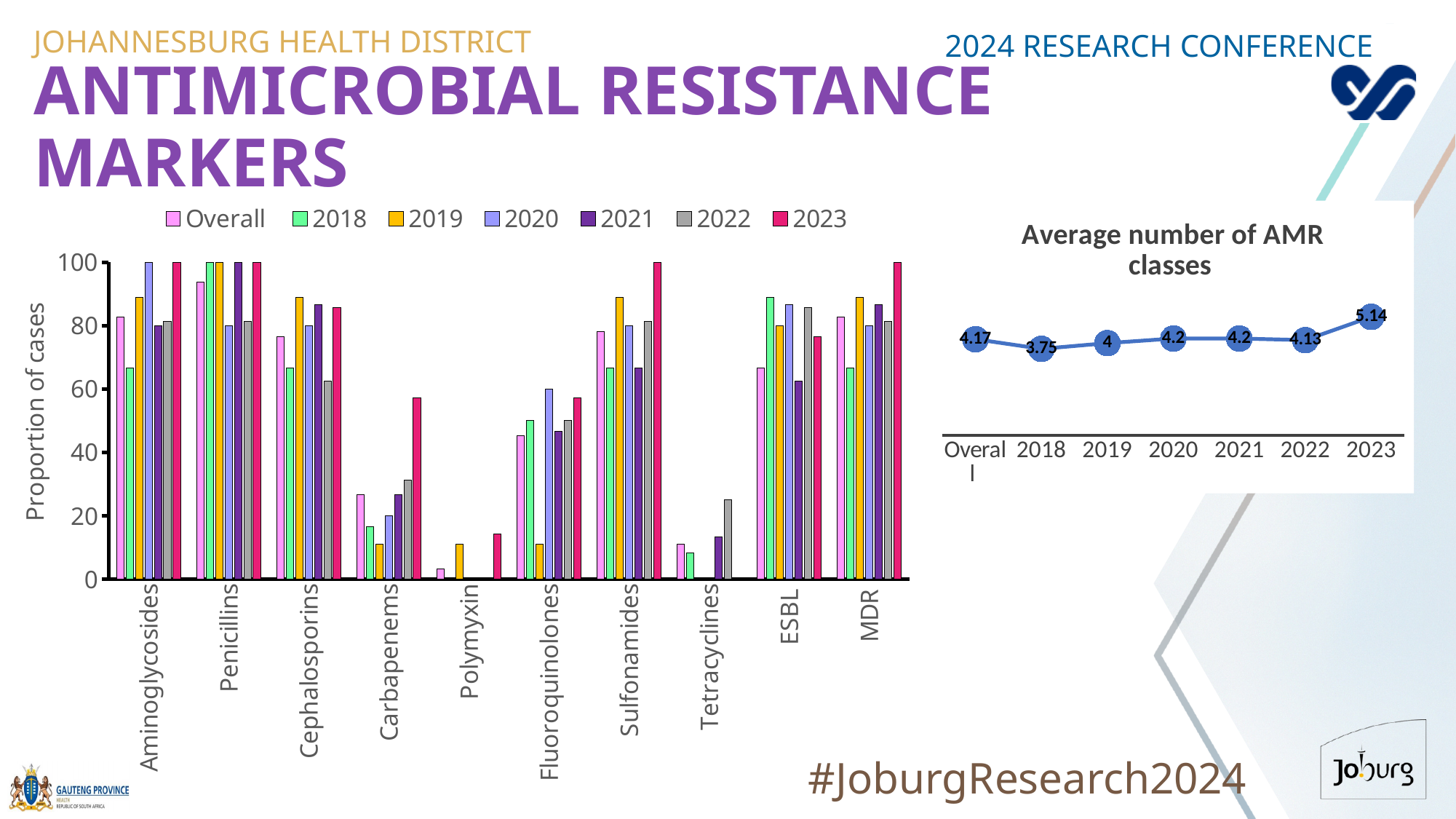
In the 'Average number of AMR classes' chart, which category has the highest value? 2023 In the bar chart on the left, how many series does the legend list? 7 In the 'Average number of AMR classes' chart, what is the value for 2023? 5.14 In the 'Average number of AMR classes' chart, what is the difference between the 2023 value and the 2018 value? 1.39 In the 'Average number of AMR classes' chart, which is larger, the value for 2020 or the value for 2022? 2020 In the bar chart on the left, how many antimicrobial categories are shown on the x axis? 10 In the bar chart on the left, is the 2023 value for Carbapenems greater or less than 40? greater In the 'Average number of AMR classes' chart, which category has the lowest value? 2018 In the 'Average number of AMR classes' chart, how many data points are plotted? 7 What kind of chart is the 'Average number of AMR classes' chart? Line chart In the 'Average number of AMR classes' chart, what is the value for 2018? 3.75 In the bar chart on the left, is the Overall value for Polymyxin greater or less than 20? less